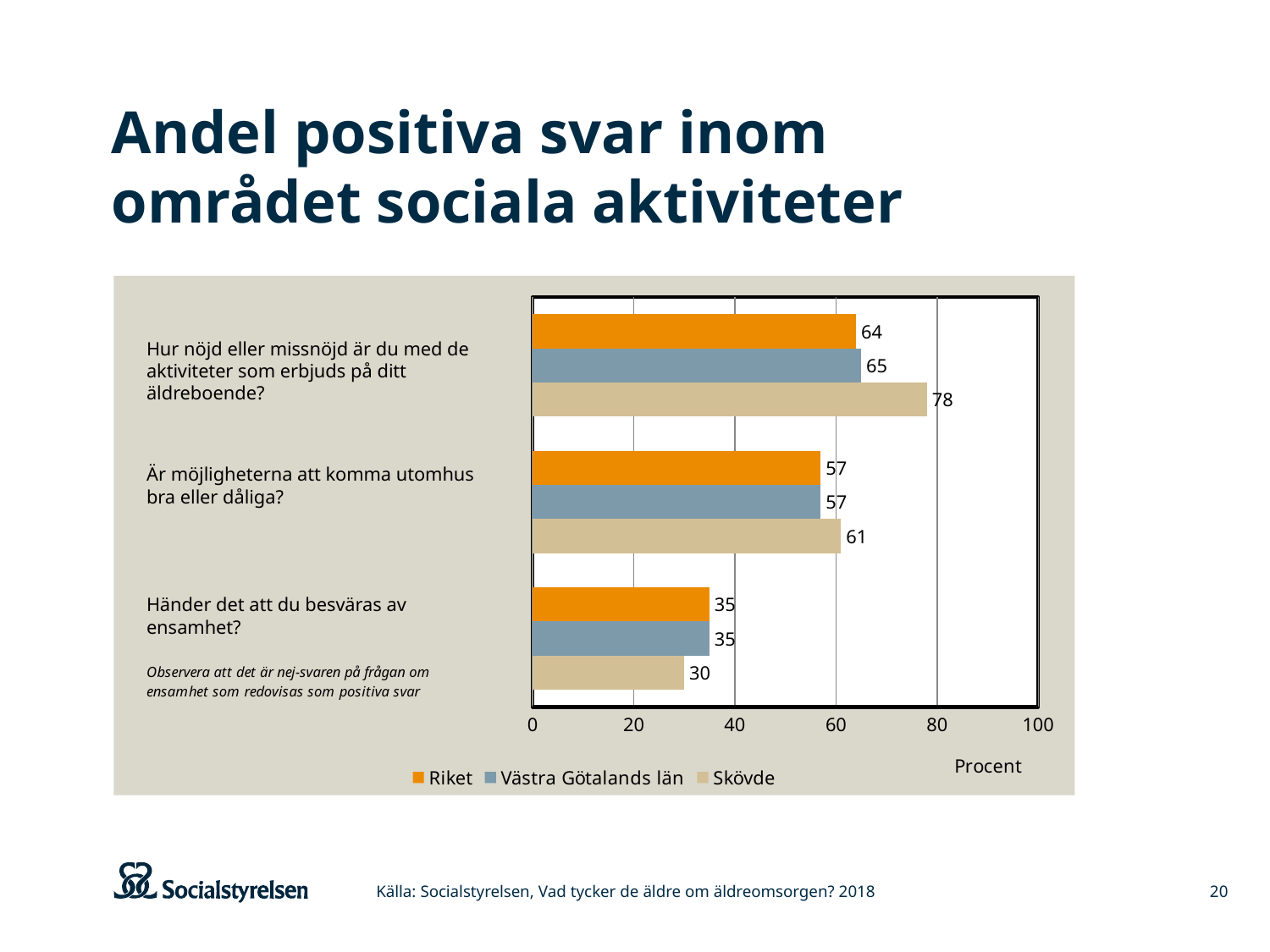
What is the difference between Skövde and Riket on the question "Hur nöjd eller missnöjd är du med de aktiviteter som erbjuds på ditt äldreboende?"? 14 What kind of chart is shown on the slide? Bar chart Which series has the lowest value on the question "Händer det att du besväras av ensamhet?"? Skövde Is the value for Skövde on the question "Händer det att du besväras av ensamhet?" greater or less than 40? less What is the value for Riket on the question "Är möjligheterna att komma utomhus bra eller dåliga?"? 57 What is the value for Skövde on the question "Hur nöjd eller missnöjd är du med de aktiviteter som erbjuds på ditt äldreboende?"? 78 Which question has the highest value for Skövde? Hur nöjd eller missnöjd är du med de aktiviteter som erbjuds på ditt äldreboende? How many series does the legend list? 3 What is the label on the horizontal axis of the chart? Procent Which is larger on the question "Är möjligheterna att komma utomhus bra eller dåliga?": Skövde or Västra Götalands län? Skövde What is the value for Västra Götalands län on the question "Händer det att du besväras av ensamhet?"? 35 How many questions (categories) are shown on the chart? 3